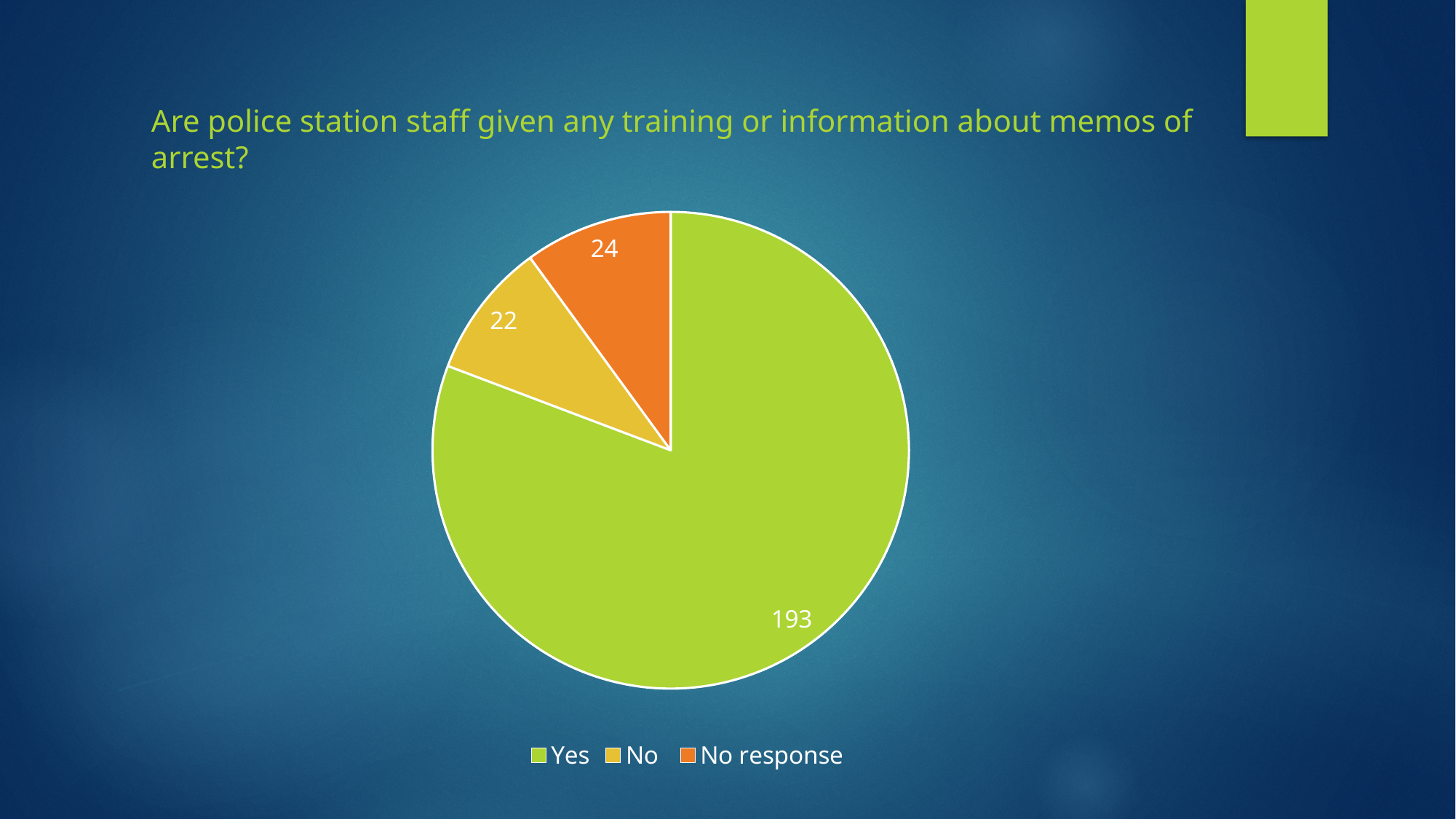
What value is shown for the Yes slice? 193 What value is shown for the No slice? 22 How many slices does the pie chart have? 3 What share of the pie does the Yes slice represent, to one decimal place? 80.8% What is the total of all the slice values in the pie chart? 239 What kind of chart is shown on the slide? Pie chart What is the difference between the Yes value and the No response value? 169 What value is shown for the No response slice? 24 Which category has the largest slice of the pie? Yes Which is larger, the No slice or the No response slice? No response What is the title of the chart on the slide? Are police station staff given any training or information about memos of arrest? Which category has the smallest slice of the pie? No